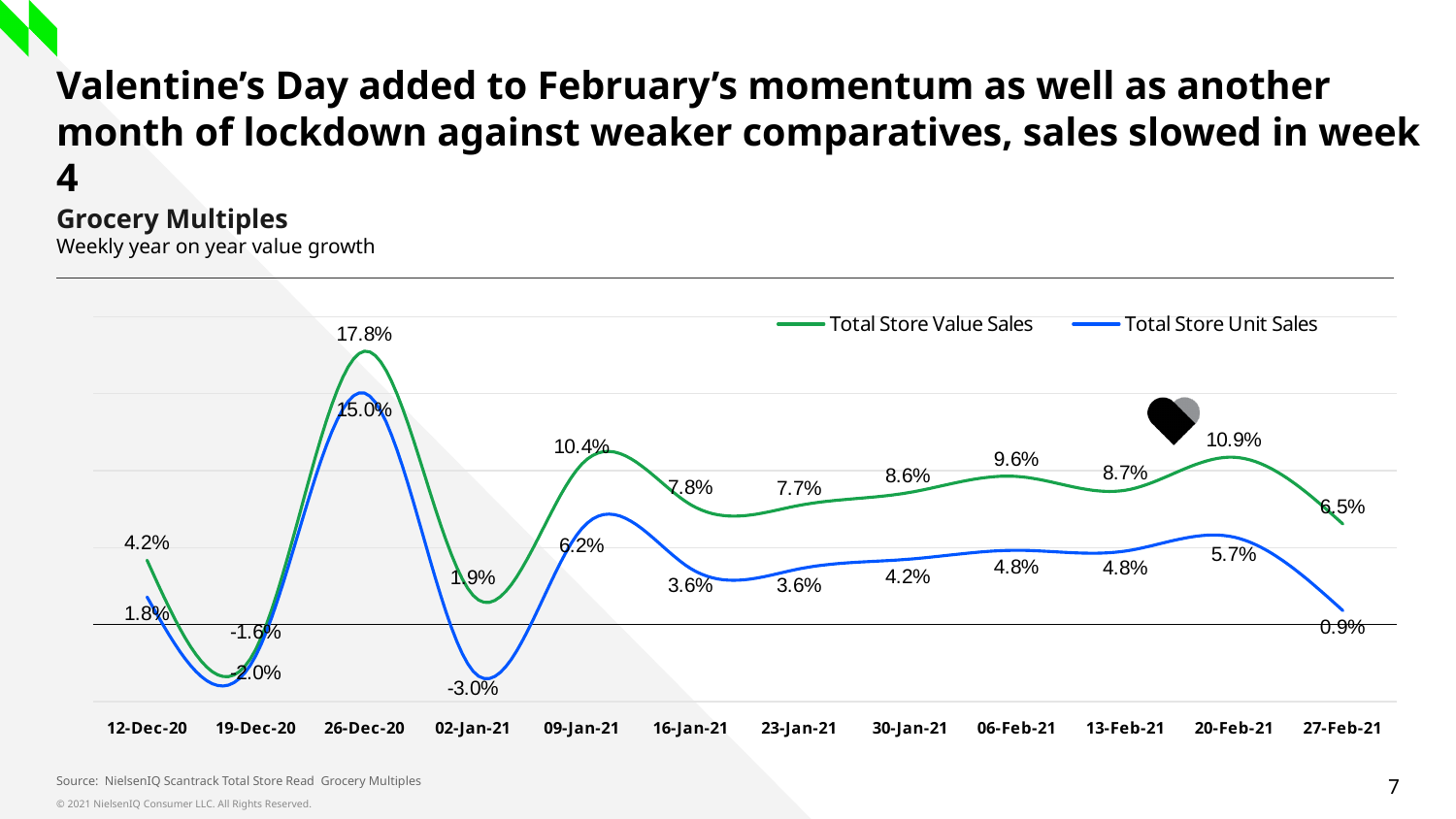
On which date is Total Store Value Sales growth highest? 26-Dec-20 What is the difference between Total Store Value Sales and Total Store Unit Sales growth on 20-Feb-21? 5.2 percentage points On which date is Total Store Unit Sales growth lowest? 02-Jan-21 Does Total Store Value Sales growth rise or fall from 20-Feb-21 to 27-Feb-21? Fall What colour is the Total Store Unit Sales line? Blue What is the Total Store Unit Sales growth for 02-Jan-21? -3.0% How many weekly dates are plotted along the x axis? 12 What kind of chart is shown on the slide? Line chart What is the Total Store Unit Sales growth for 27-Feb-21? 0.9% On 09-Jan-21, which series has the higher growth, Total Store Value Sales or Total Store Unit Sales? Total Store Value Sales How many series does the legend list? 2 What is the Total Store Value Sales growth for 26-Dec-20? 17.8%